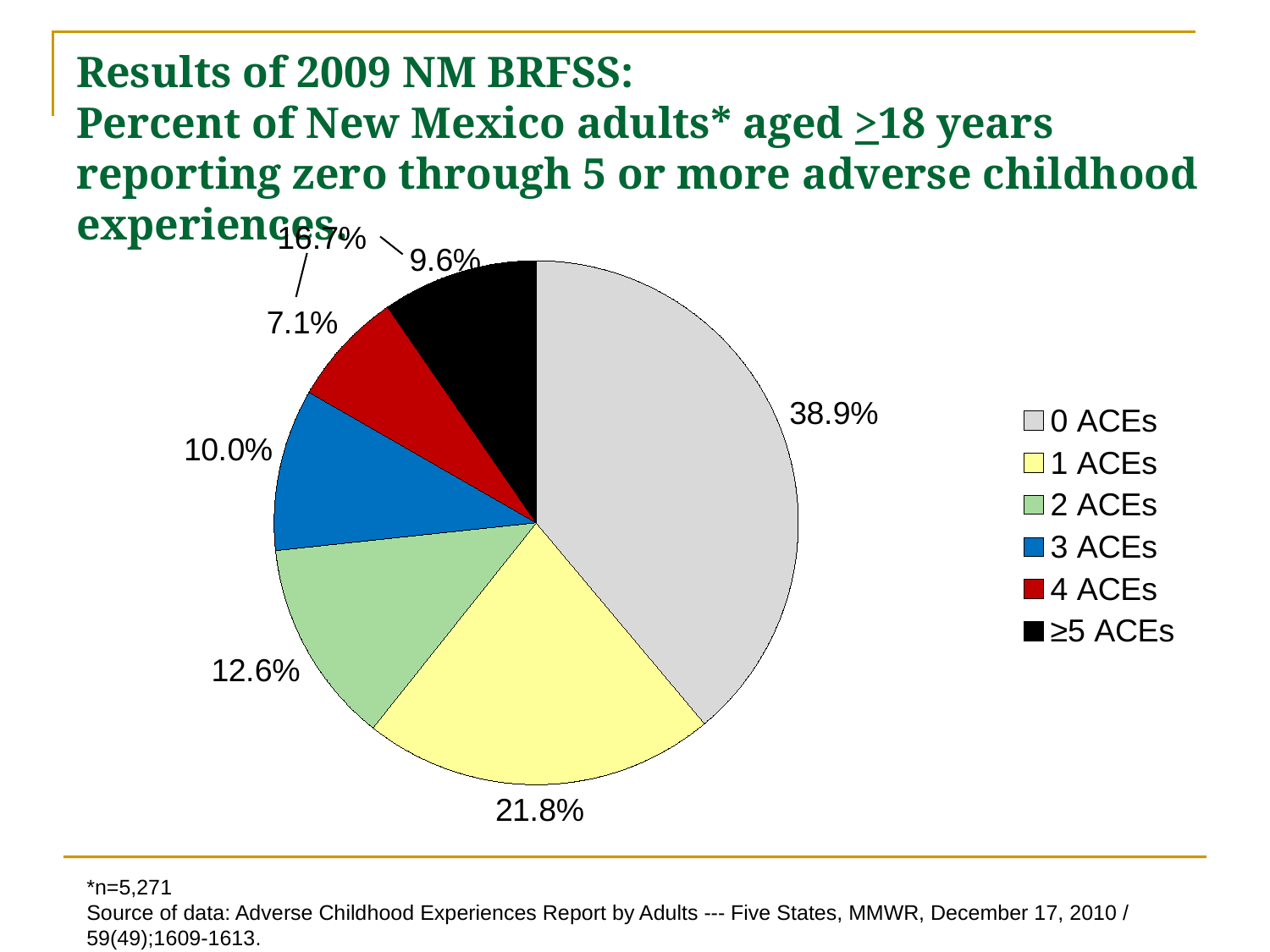
Which slice is larger, 3 ACEs or ≥5 ACEs? 3 ACEs How many categories does the legend list? 6 What percentage of New Mexico adults reported 3 ACEs? 10.0% What percentage of New Mexico adults reported ≥5 ACEs? 9.6% What percentage of New Mexico adults reported 2 ACEs? 12.6% Which ACE category has the smallest share of the pie? 4 ACEs What percentage of New Mexico adults reported 0 ACEs? 38.9% What percentage of New Mexico adults reported 4 ACEs? 7.1% What percentage of New Mexico adults reported 1 ACEs? 21.8% Which ACE category has the largest share of the pie? 0 ACEs What type of chart is shown on the slide? Pie chart What is the difference in percentage points between the 0 ACEs and 1 ACEs slices? 17.1